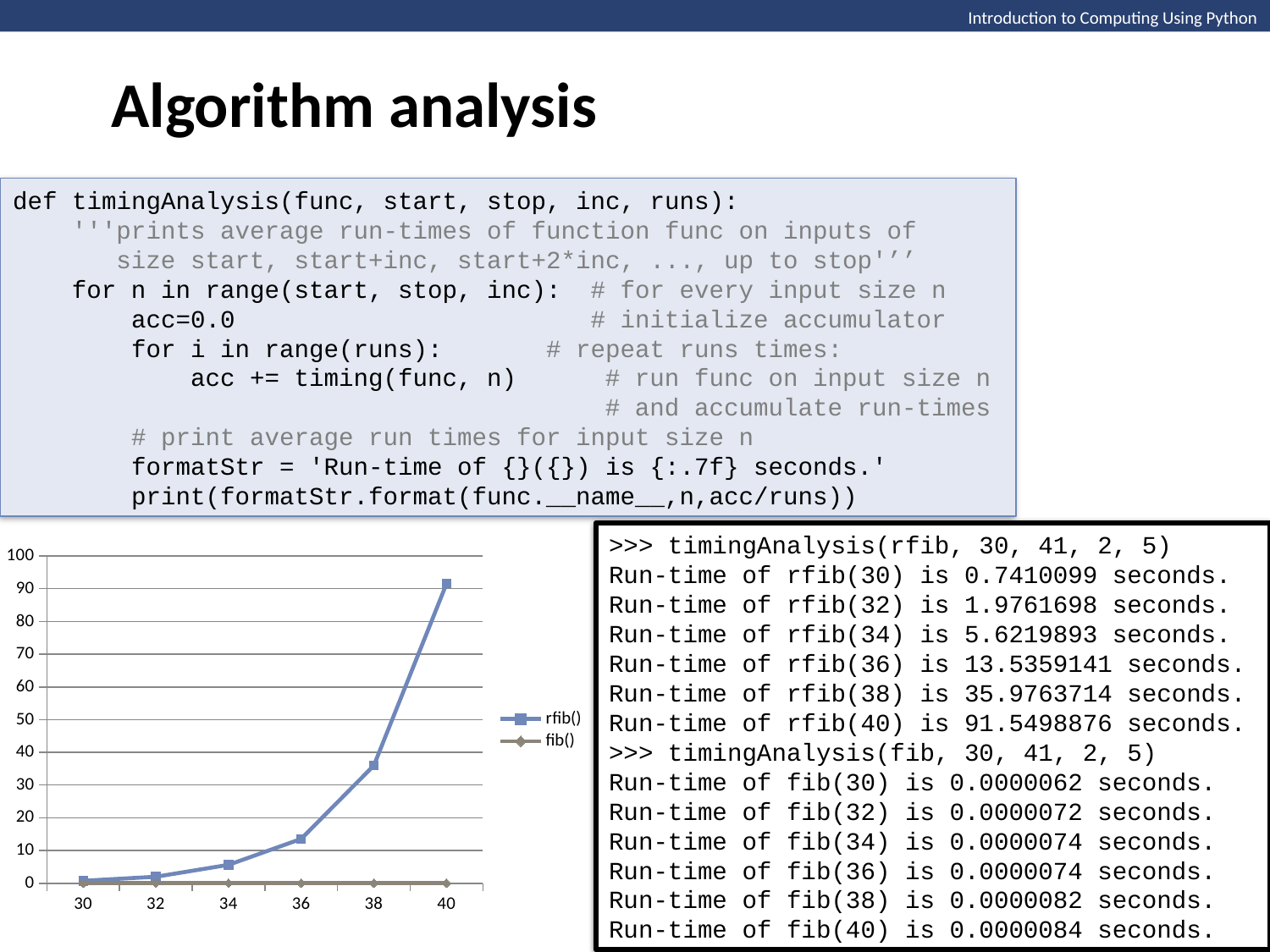
At input size 40, which series has the larger value, rfib() or fib()? rfib() Does the rfib() series rise or fall as the input size increases from 30 to 40? rises How many series does the chart's legend list? 2 At which input size does the rfib() series reach its highest value? 40 Is the value of rfib() at input size 36 greater or less than 20? less What kind of chart is shown on the slide? line chart How many x-axis categories (input sizes) are plotted on the chart? 6 What is the highest value shown on the chart's y axis? 100 Is the value of rfib() at input size 38 greater or less than 30? greater Is the value of rfib() at input size 40 greater or less than 80? greater What are the two series named in the chart's legend? rfib() and fib()